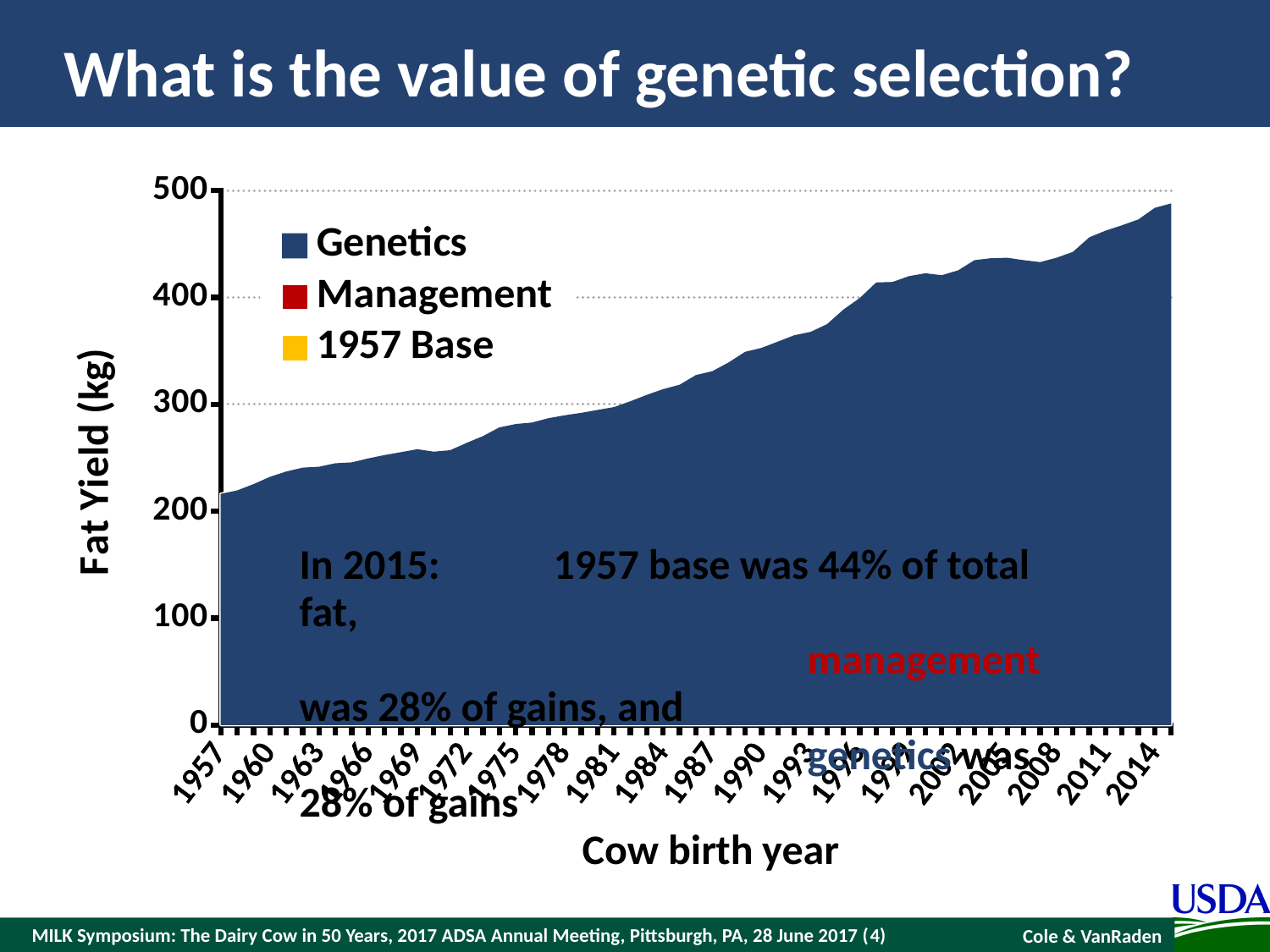
Does the plotted fat yield generally rise or fall as cow birth year increases from 1957 to 2014? Rise Is the fat yield value for 2014 greater or less than 400? greater Is the fat yield value for 1972 greater or less than 300? less What is the title of the chart's y axis? Fat Yield (kg) What are the three series named in the chart legend? Genetics, Management, 1957 Base Is the fat yield value for 1957 greater or less than 200? greater How many series does the chart legend list? 3 How many year labels are shown along the x axis of the chart? 20 What kind of chart is shown on the slide? Area chart